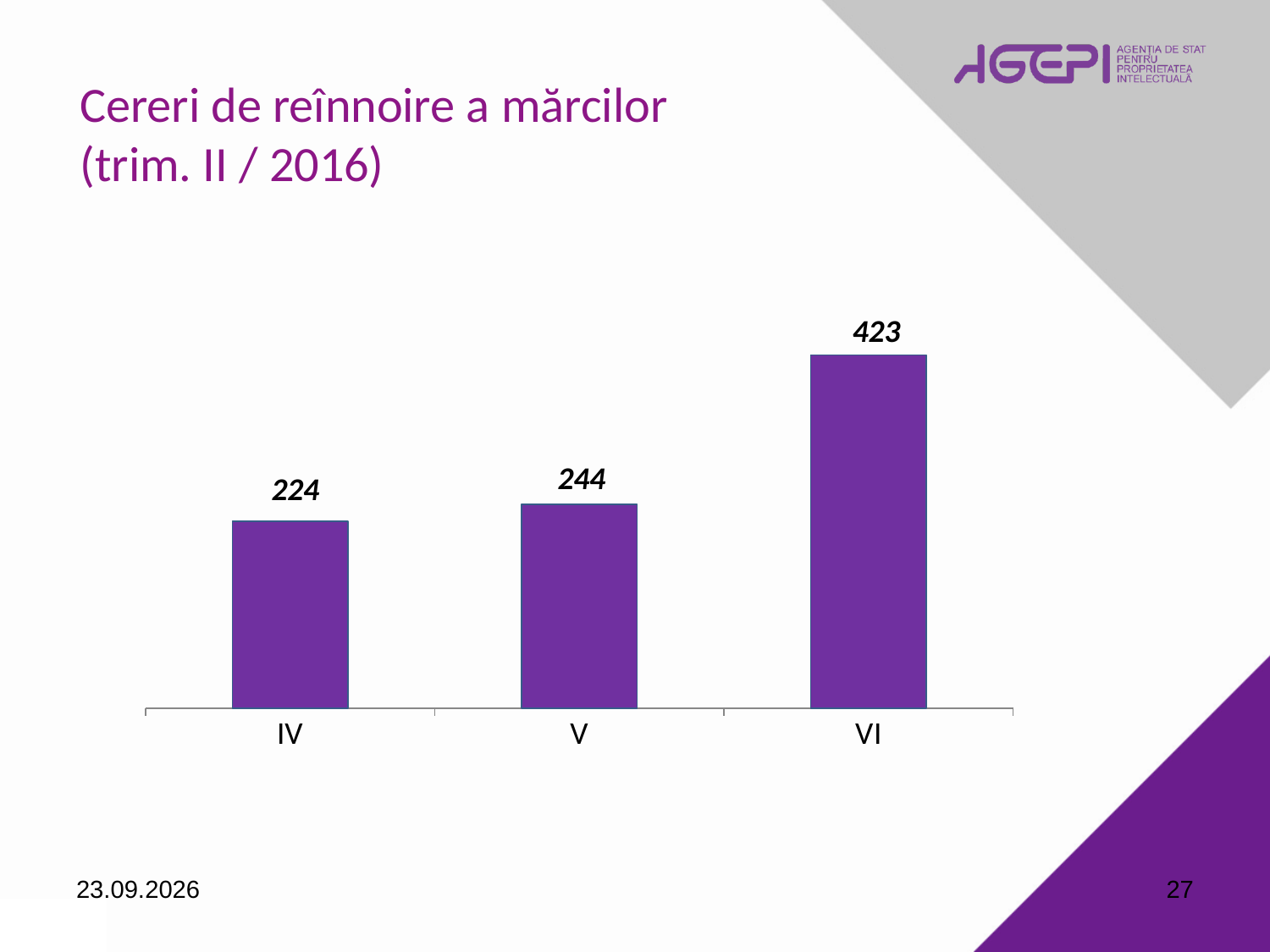
Do the values rise or fall from IV to VI along the x axis? rise What kind of chart is shown on the slide? bar chart Which category has the lowest value? IV Which category has the highest value? VI What is the value for category VI? 423 Which is larger, the value for IV or the value for V? V What is the difference between the values for V and IV? 20 What is the value for category V? 244 How many categories are shown on the x axis? 3 What is the value for category IV? 224 What is the difference between the values for VI and V? 179 What is the title of the slide containing the chart? Cereri de reînnoire a mărcilor (trim. II / 2016)